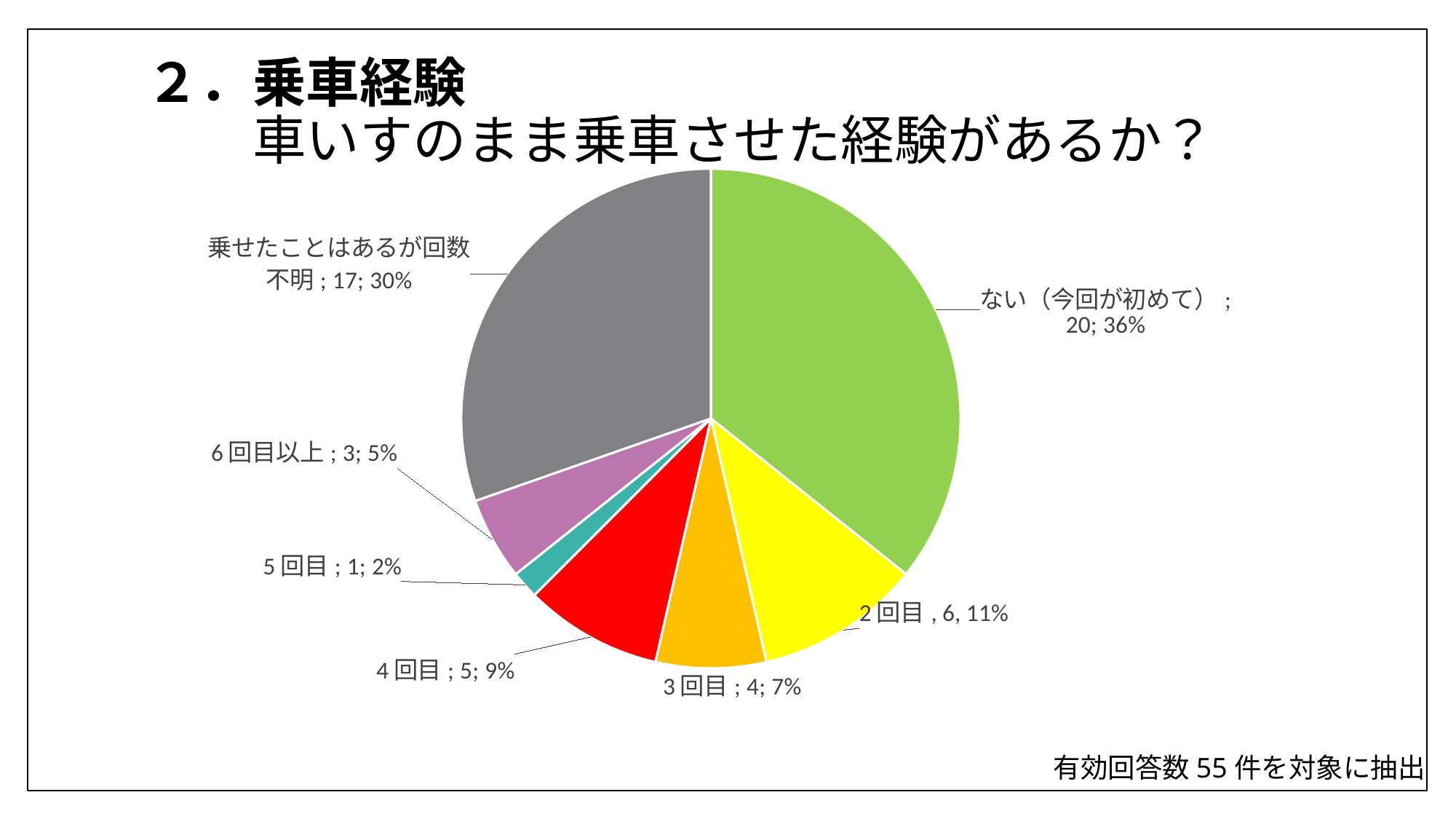
What is the difference in count between ない（今回が初めて） and 乗せたことはあるが回数不明? 3 What percentage share does 乗せたことはあるが回数不明 have? 30% What colour is the slice for 4回目? red What is the count for 4回目? 5 Which category has the smallest slice? 5回目 How many slices does the pie chart have? 7 What kind of chart is shown on the slide? pie chart What percentage share does 2回目 have? 11% What is the count for ない（今回が初めて）? 20 Which has a larger count, 3回目 or 6回目以上? 3回目 What is the count for 5回目? 1 Which category has the largest slice? ない（今回が初めて）